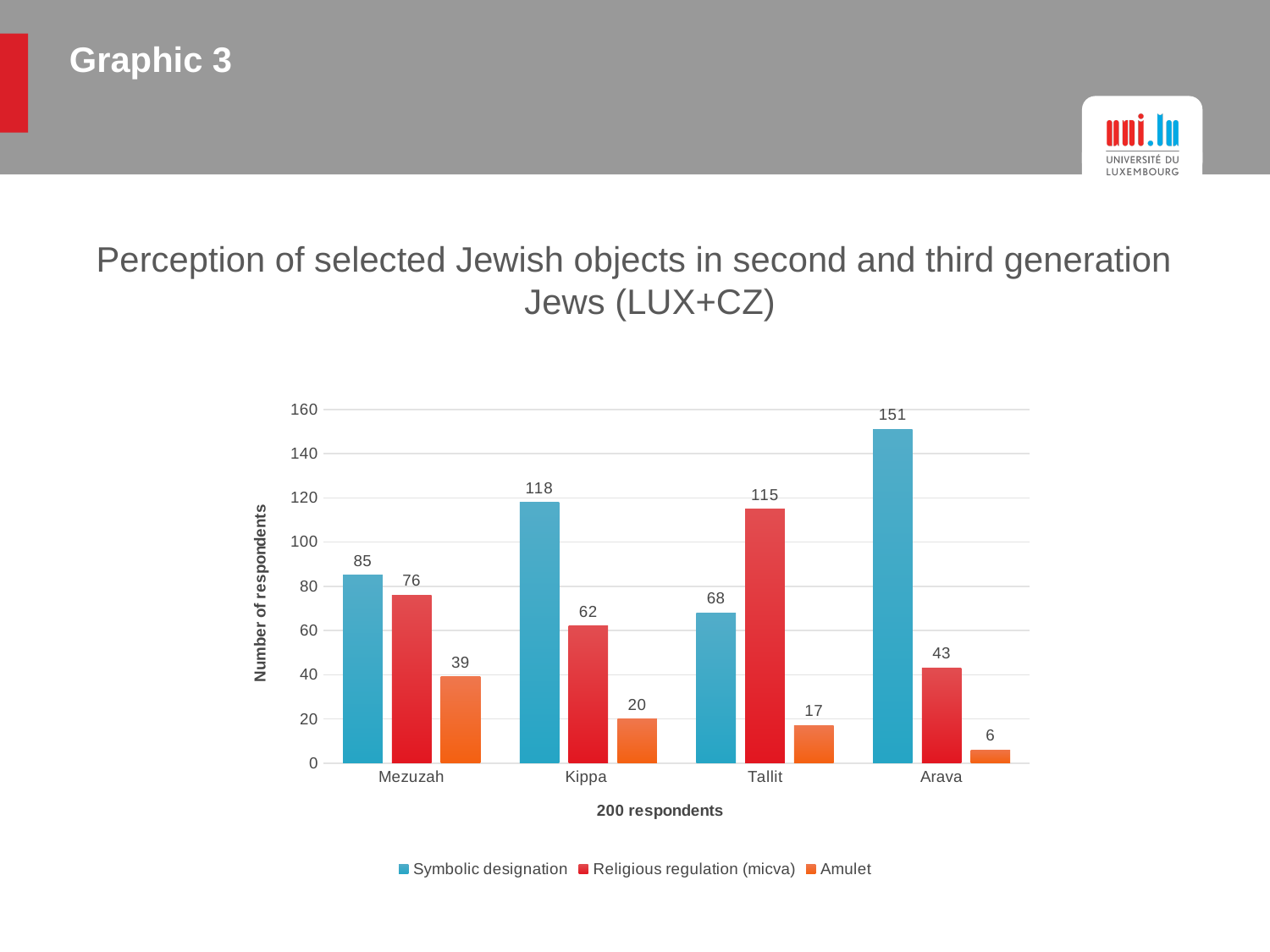
How many categories are shown on the x axis? 4 What is the difference between the Symbolic designation and Religious regulation (micva) values for Kippa? 56 Which category has the lowest Amulet value? Arava How many series does the legend list? 3 What is the value for Religious regulation (micva) for Tallit? 115 What is the value for Amulet for Mezuzah? 39 What is the label of the y axis? Number of respondents What kind of chart is shown? Bar chart Do the Amulet values rise or fall from Mezuzah to Arava? Fall What is the value for Symbolic designation for Arava? 151 For Tallit, which is larger: Symbolic designation or Religious regulation (micva)? Religious regulation (micva) Which category has the highest Symbolic designation value? Arava